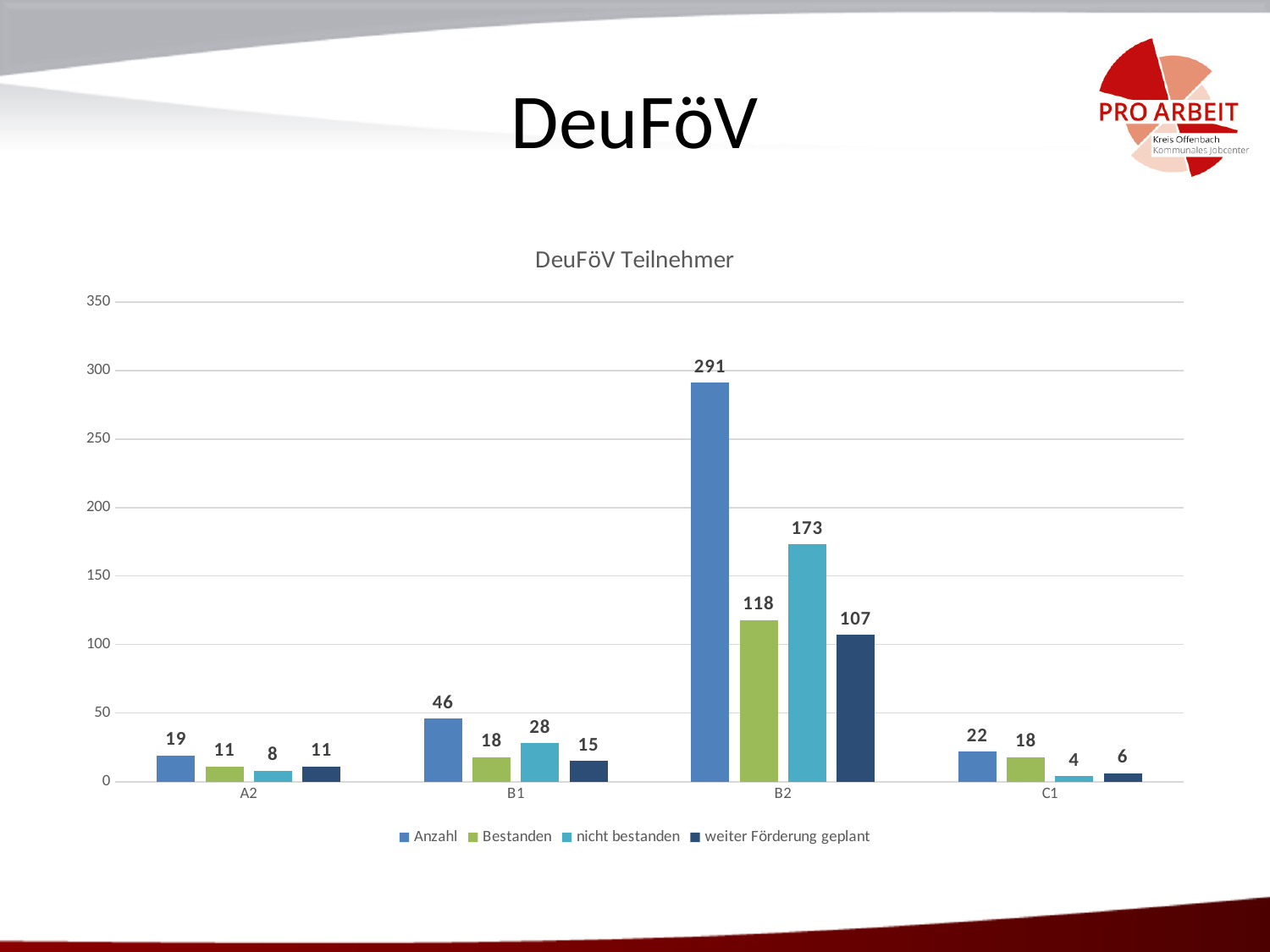
What is the difference between Anzahl and Bestanden for B2? 173 What is the value of Bestanden for A2? 11 How many series does the legend list? 4 What is the value of weiter Förderung geplant for B1? 15 What is the value of Anzahl for B2? 291 What is the title of the chart? DeuFöV Teilnehmer Which category has the lowest nicht bestanden value? C1 What kind of chart is shown? bar chart Which is larger for B1: Bestanden or nicht bestanden? nicht bestanden What is the value of nicht bestanden for C1? 4 Which category has the highest Anzahl value? B2 How many categories are shown on the x axis? 4